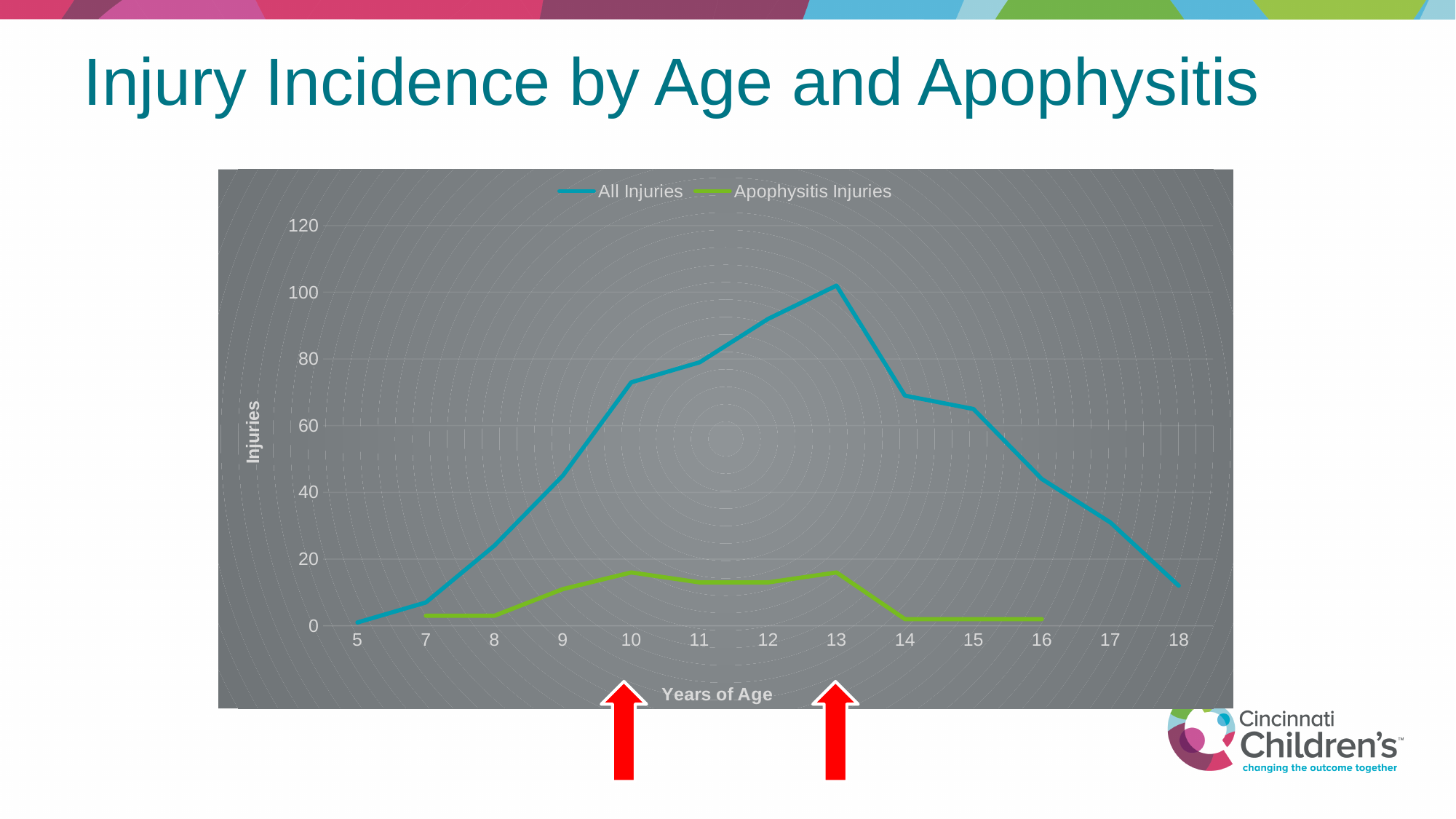
What kind of chart is shown on the slide? line chart Is the All Injuries value at age 13 greater or less than 80? greater At which age does the All Injuries series reach its highest value? 13 How many age categories are shown on the x axis? 13 At which age is the All Injuries series lowest? 5 Is the All Injuries value at age 18 greater or less than 20? less Does the All Injuries series rise or fall from age 13 to age 18? fall How many series does the legend list? 2 What is the label of the x axis? Years of Age Is the All Injuries value at age 10 greater or less than 60? greater Which is larger for All Injuries: the value at age 12 or the value at age 14? age 12